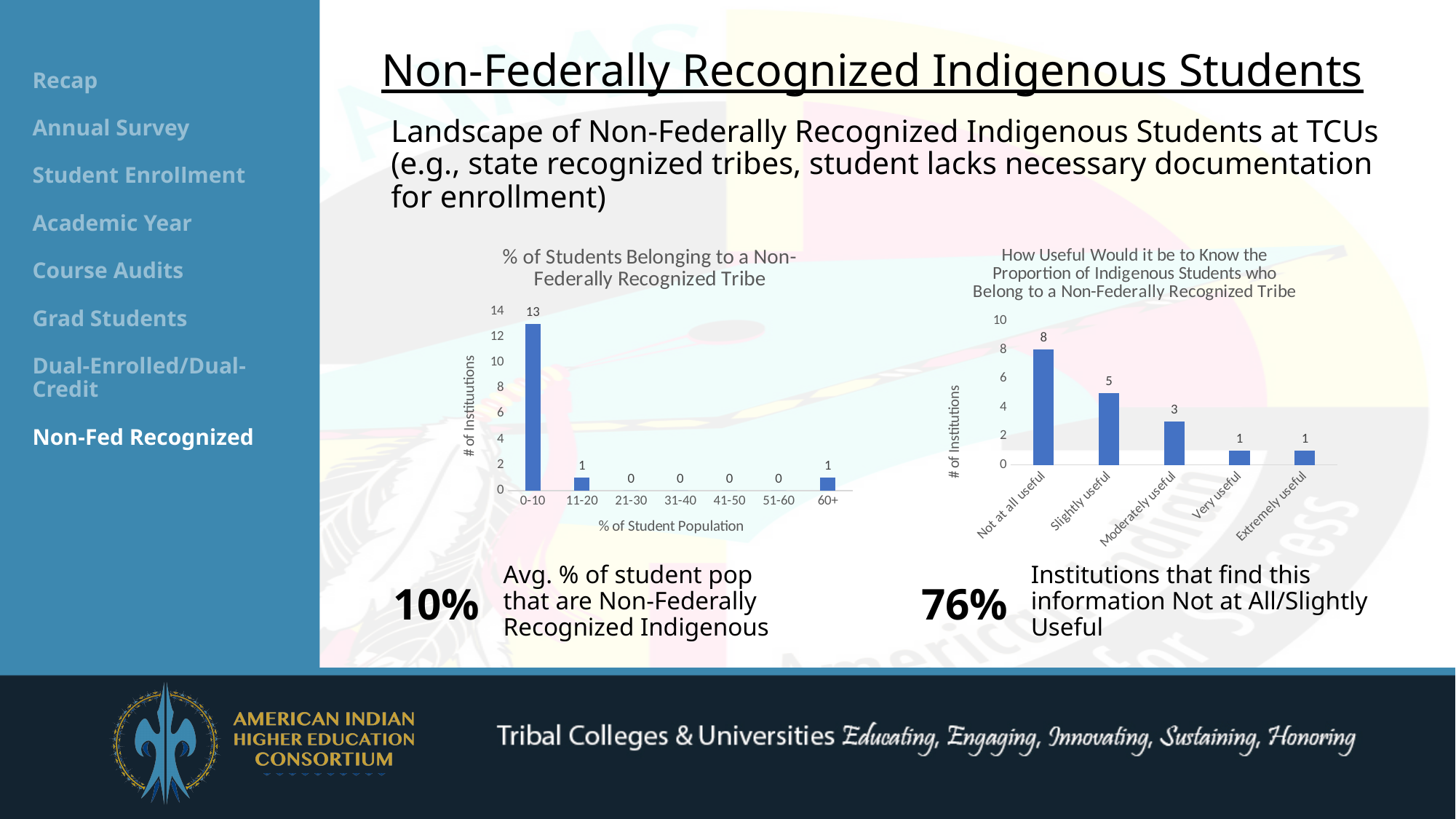
In the left chart '% of Students Belonging to a Non-Federally Recognized Tribe', what is the value for the 60+ category? 1 In the left chart '% of Students Belonging to a Non-Federally Recognized Tribe', how many categories are shown on the x axis? 7 In the left chart '% of Students Belonging to a Non-Federally Recognized Tribe', which category has the highest number of institutions? 0-10 In the right chart 'How Useful Would it be to Know the Proportion of Indigenous Students who Belong to a Non-Federally Recognized Tribe', what is the difference between 'Not at all useful' and 'Slightly useful'? 3 In the left chart '% of Students Belonging to a Non-Federally Recognized Tribe', how many institutions are in the 0-10 category? 13 In the right chart 'How Useful Would it be to Know the Proportion of Indigenous Students who Belong to a Non-Federally Recognized Tribe', which is larger: 'Slightly useful' or 'Moderately useful'? Slightly useful In the left chart '% of Students Belonging to a Non-Federally Recognized Tribe', how many institutions are in the 11-20 category? 1 In the right chart 'How Useful Would it be to Know the Proportion of Indigenous Students who Belong to a Non-Federally Recognized Tribe', how many institutions answered 'Not at all useful'? 8 What type of chart is the right chart 'How Useful Would it be to Know the Proportion of Indigenous Students who Belong to a Non-Federally Recognized Tribe'? Bar chart In the right chart 'How Useful Would it be to Know the Proportion of Indigenous Students who Belong to a Non-Federally Recognized Tribe', how many institutions answered 'Moderately useful'? 3 In the left chart '% of Students Belonging to a Non-Federally Recognized Tribe', what is the difference between the 0-10 and 11-20 values? 12 In the right chart 'How Useful Would it be to Know the Proportion of Indigenous Students who Belong to a Non-Federally Recognized Tribe', which response category has the highest value? Not at all useful